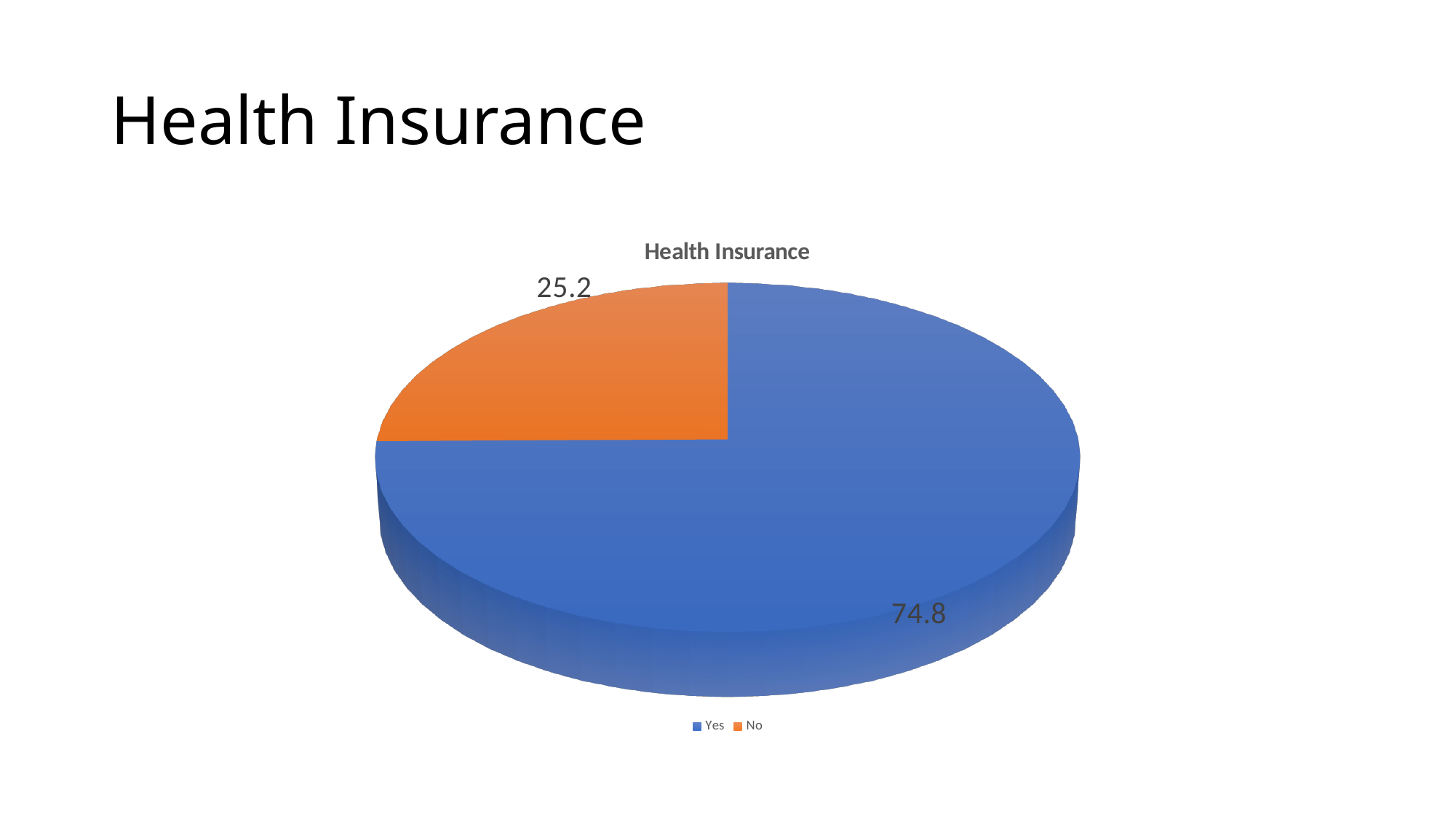
What colour is the slice for No? orange Which category has the smallest slice? No What type of chart is shown on the slide? pie chart What is the title of the chart? Health Insurance Which is larger, the value for Yes or the value for No? Yes How many entries does the legend list? 2 How many slices does the pie chart have? 2 What is the value for No? 25.2 Which category has the largest slice? Yes What is the value for Yes? 74.8 What is the difference between the values for Yes and No? 49.6